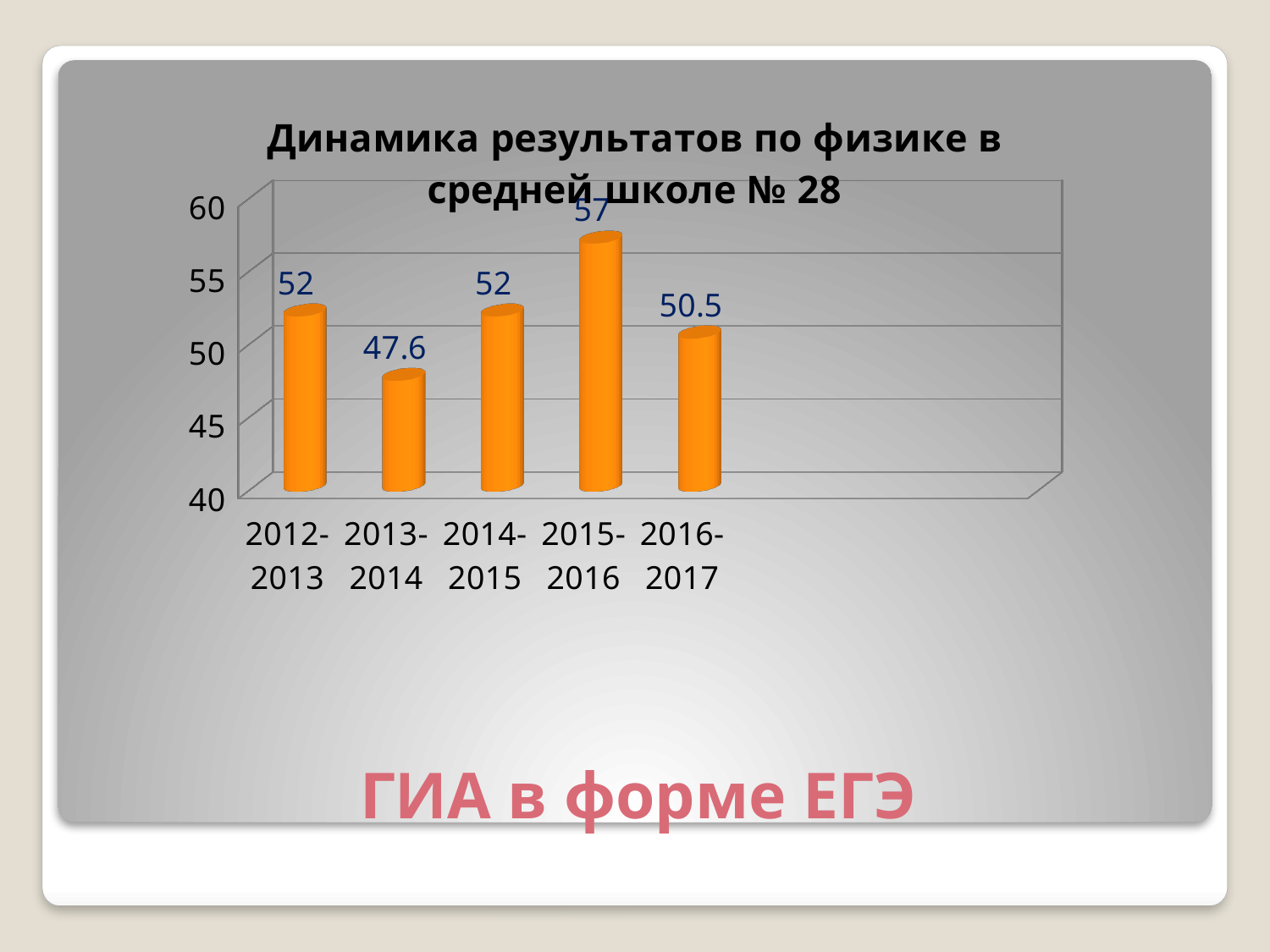
What is the value for 2016-2017? 50.5 Is the value for 2015-2016 greater or less than 55? greater What is the value for 2015-2016? 57 How many academic years are shown on the chart? 5 What is the title of the chart? Динамика результатов по физике в средней школе № 28 What is the value for 2013-2014? 47.6 What is the difference between the values for 2014-2015 and 2016-2017? 1.5 Which academic year has the highest value? 2015-2016 Which academic year has the lowest value? 2013-2014 What is the difference between the values for 2015-2016 and 2013-2014? 9.4 What kind of chart is shown on the slide? bar chart Which is larger, the value for 2012-2013 or the value for 2013-2014? 2012-2013